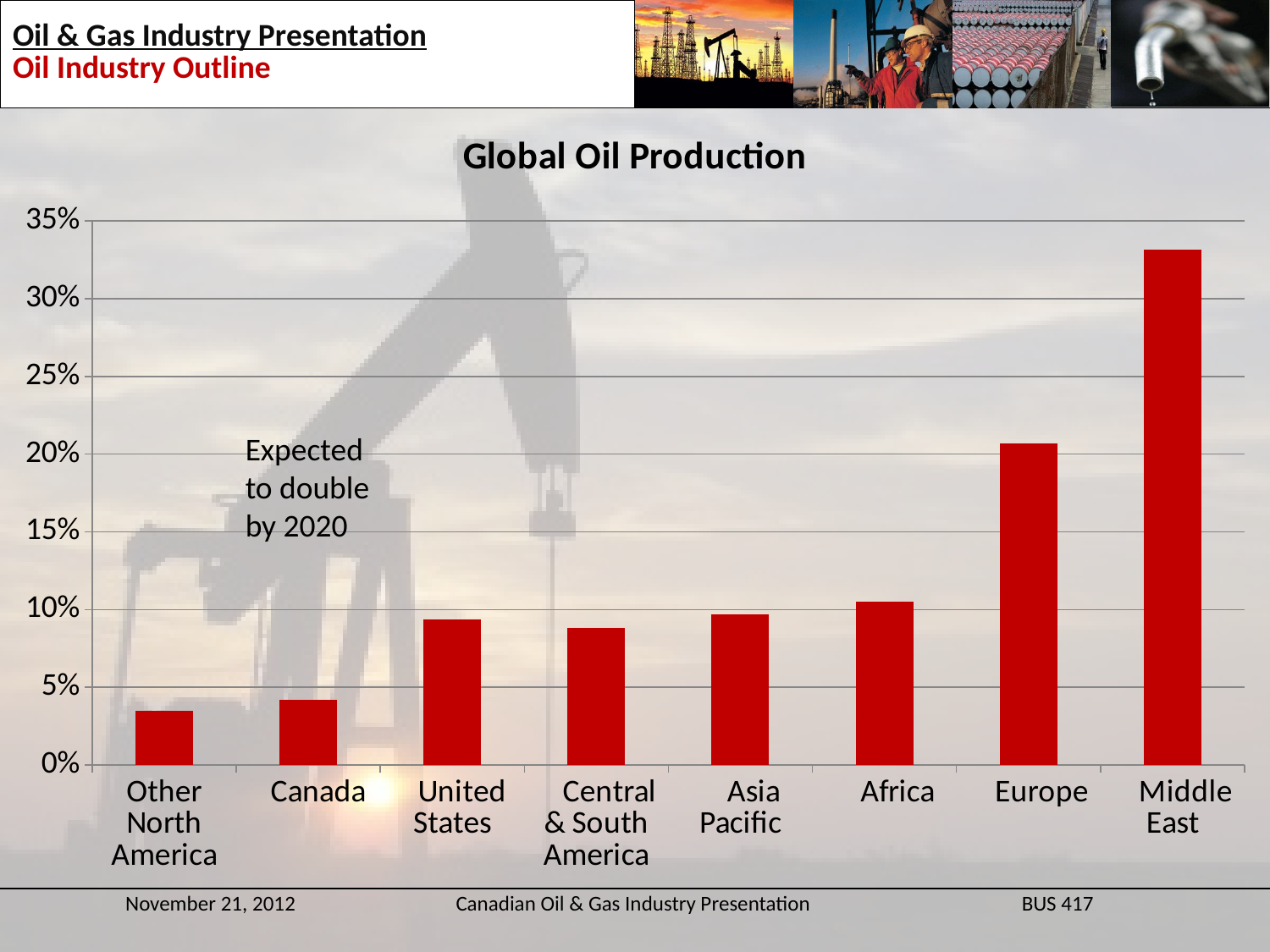
Which is larger, the value for United States or the value for Canada? United States What is the title of the chart? Global Oil Production Is the value for Canada greater or less than 5%? less Which category has the highest value in the chart? Middle East Is the value for Central & South America greater or less than 10%? less Is the value for Europe greater or less than 15%? greater Which is larger, the value for Europe or the value for Africa? Europe How many categories are shown on the x axis of the chart? 8 What kind of chart is shown on the slide? bar chart Which category has the lowest value in the chart? Other North America